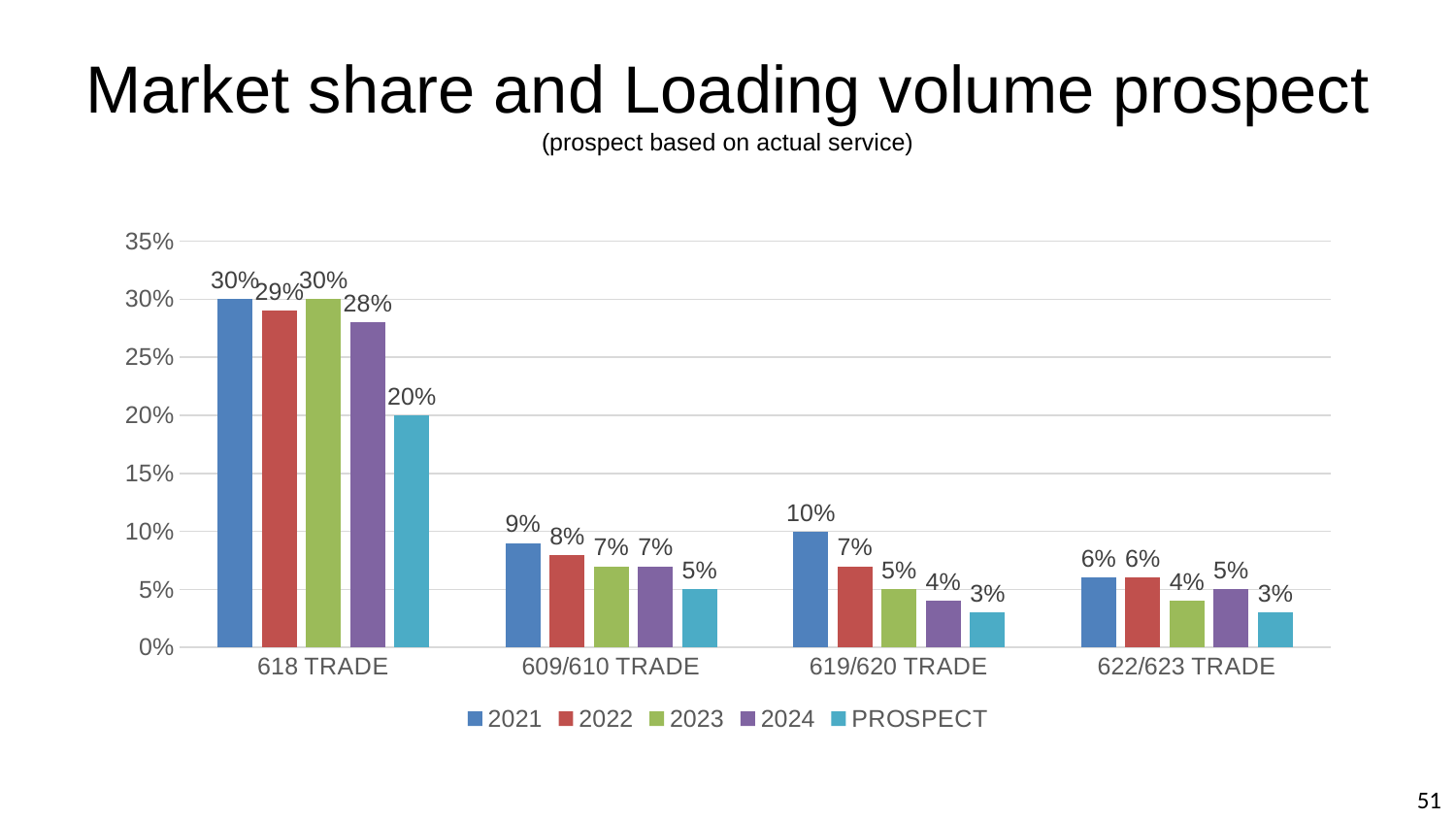
What is the difference between the 2024 and PROSPECT values for 618 TRADE? 8% What is the 2021 value for 618 TRADE? 30% How many trade categories are shown on the x axis? 4 What is the PROSPECT value for 609/610 TRADE? 5% How many series does the legend list? 5 Which trade has the highest 2021 value? 618 TRADE Which series has the lowest value for 618 TRADE? PROSPECT What kind of chart is shown on the slide? Bar chart What is the 2024 value for 619/620 TRADE? 4% What is the 2023 value for 622/623 TRADE? 4% Which is larger for 619/620 TRADE, the 2021 value or the 2022 value? 2021 Do the values for 619/620 TRADE rise or fall from 2021 to PROSPECT? Fall